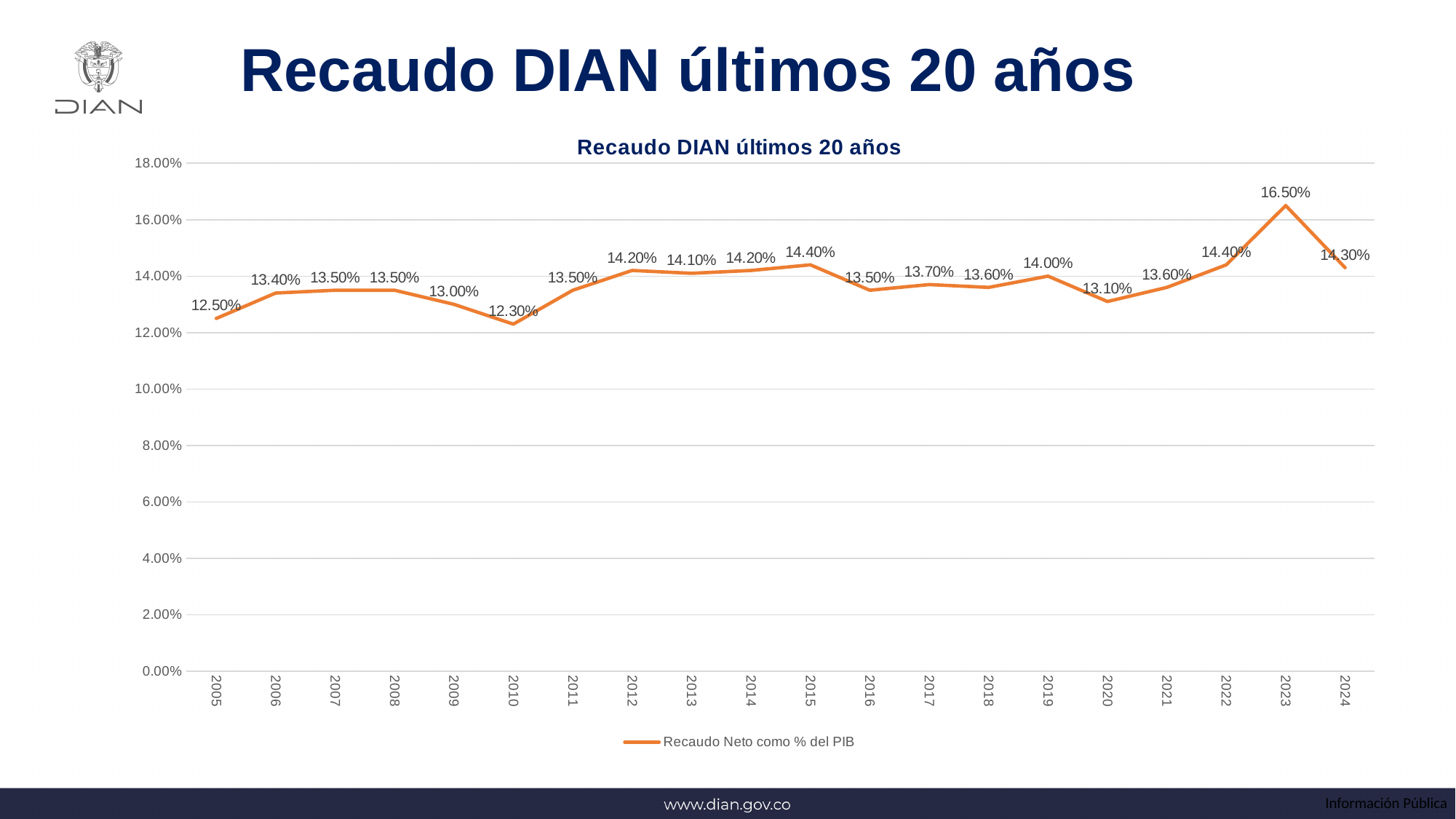
What is the value for 2023? 16.50% Which year has the lowest value? 2010 How many series does the legend list? 1 What is the value for 2024? 14.30% Is the value for 2020 greater or less than 14.00%? less What is the difference between the values for 2005 and 2006? 0.90% What is the difference between the values for 2023 and 2024? 2.20% How many years are plotted on the chart? 20 What is the value for 2010? 12.30% Which is larger, the value for 2015 or the value for 2016? 2015 Which year has the highest value? 2023 What kind of chart is shown? line chart